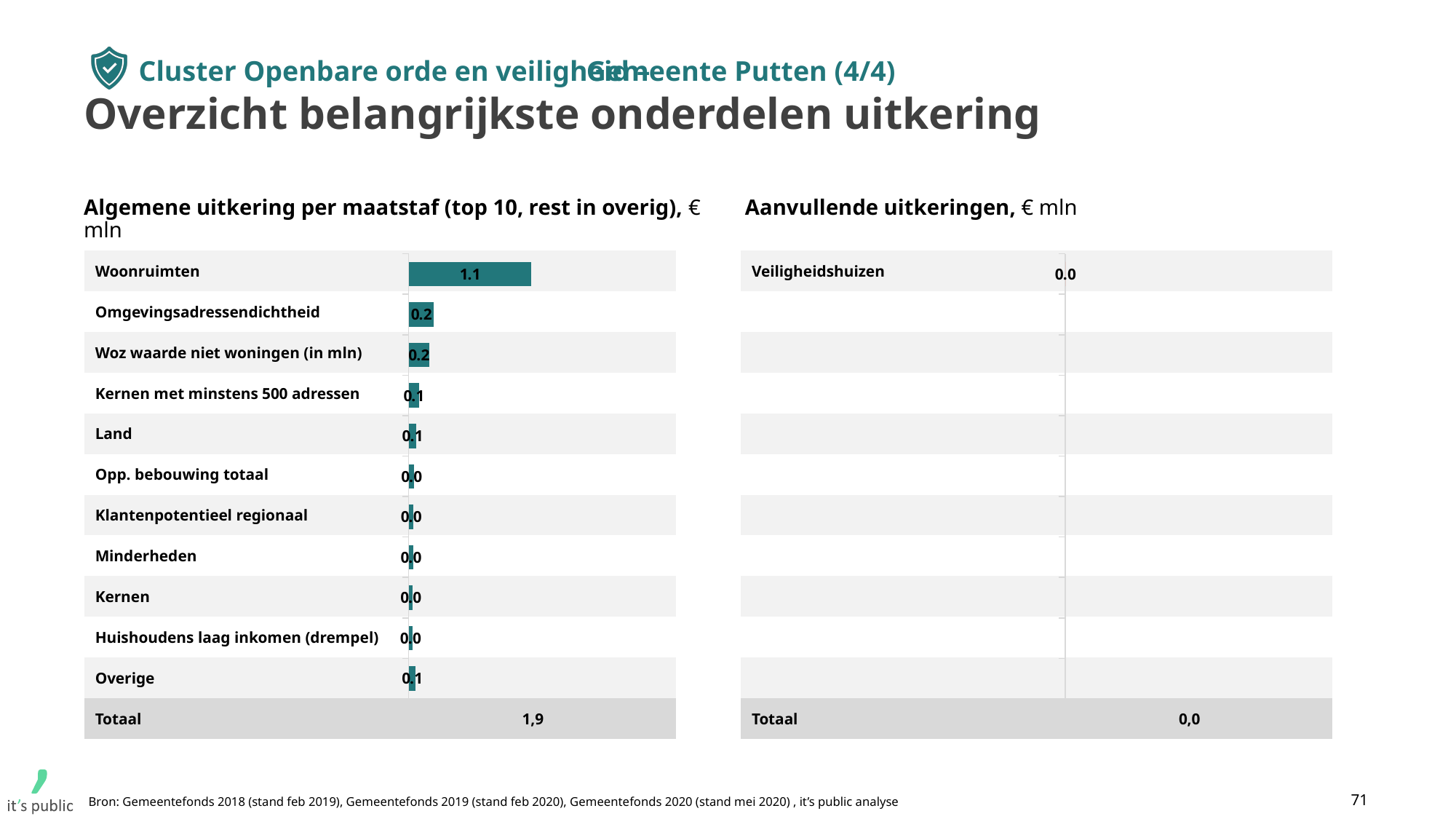
In the chart 'Algemene uitkering per maatstaf', what is the difference between the values for Woonruimten and Omgevingsadressendichtheid? 0.9 What total is shown in the Totaal row of the chart 'Algemene uitkering per maatstaf'? 1,9 In the chart 'Aanvullende uitkeringen', what is the value for Veiligheidshuizen? 0.0 In the chart 'Algemene uitkering per maatstaf', which category has the highest value? Woonruimten How many categories (excluding the Totaal row) are shown in the chart 'Algemene uitkering per maatstaf'? 11 In the chart 'Algemene uitkering per maatstaf', what is the value for Overige? 0.1 In the chart 'Algemene uitkering per maatstaf', what is the value for Kernen met minstens 500 adressen? 0.1 In the chart 'Algemene uitkering per maatstaf', what is the value for Omgevingsadressendichtheid? 0.2 In the chart 'Algemene uitkering per maatstaf', what is the value for Woonruimten? 1.1 What kind of chart is 'Algemene uitkering per maatstaf'? Bar chart In the chart 'Algemene uitkering per maatstaf', which is larger: the value for Woonruimten or the value for Land? Woonruimten What unit is stated in the title of the chart 'Aanvullende uitkeringen'? € mln